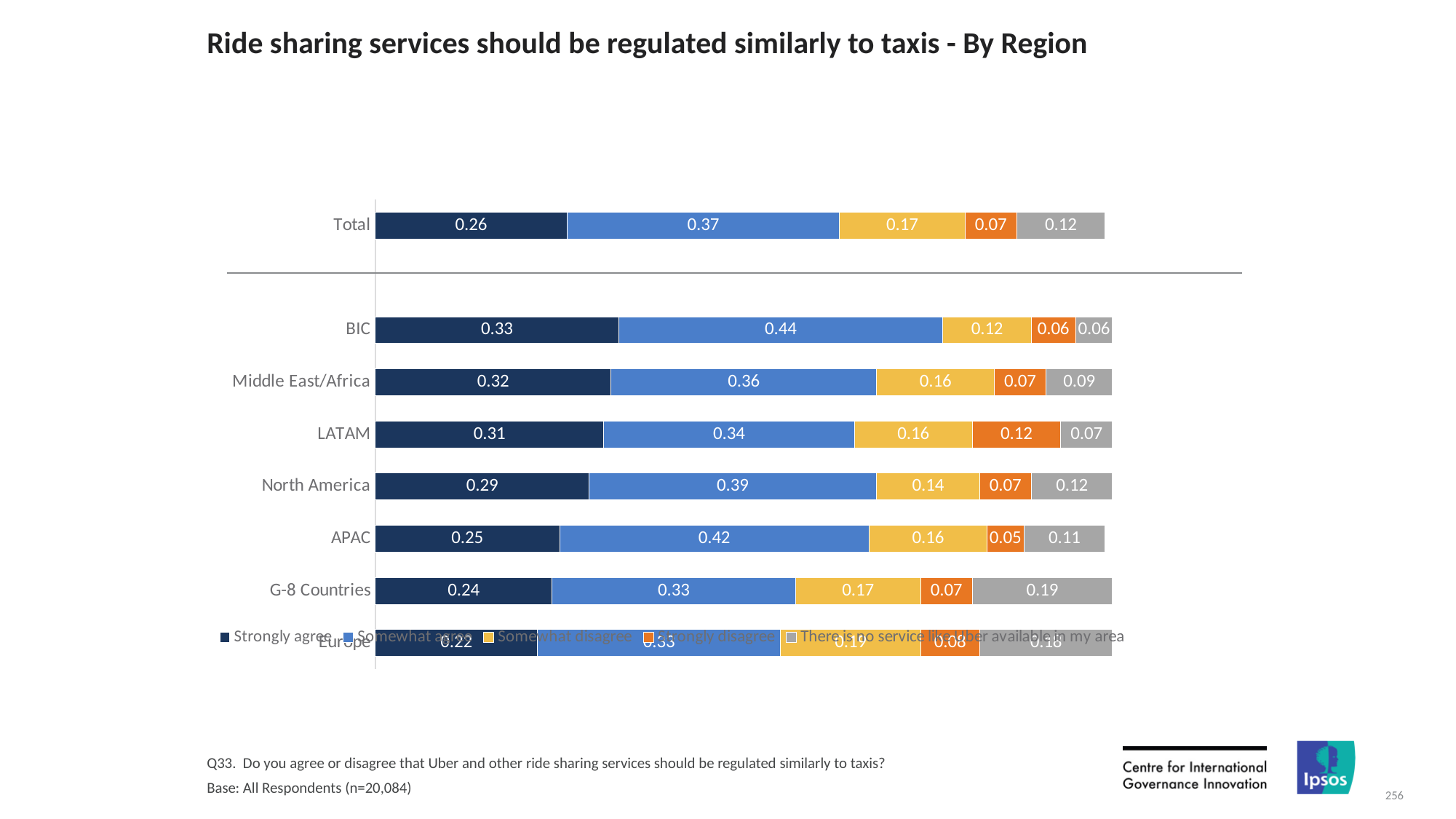
How many region bars are plotted, including Total? 8 How many series does the legend list? 5 Which region has the highest Strongly agree value? BIC What kind of chart is shown on the slide? Stacked bar chart What is the Strongly disagree value for LATAM? 0.12 Which region has the lowest Somewhat agree value? G-8 Countries and Europe (tied at 0.33) What is the Strongly agree value for BIC? 0.33 What is the 'There is no service like Uber available in my area' value for G-8 Countries? 0.19 What is the total of the Total bar across all five segments? 0.99 Which is larger, the Strongly agree value for North America or for APAC? North America What is the Somewhat agree value for APAC? 0.42 What is the difference between the Somewhat agree values for BIC and Middle East/Africa? 0.08